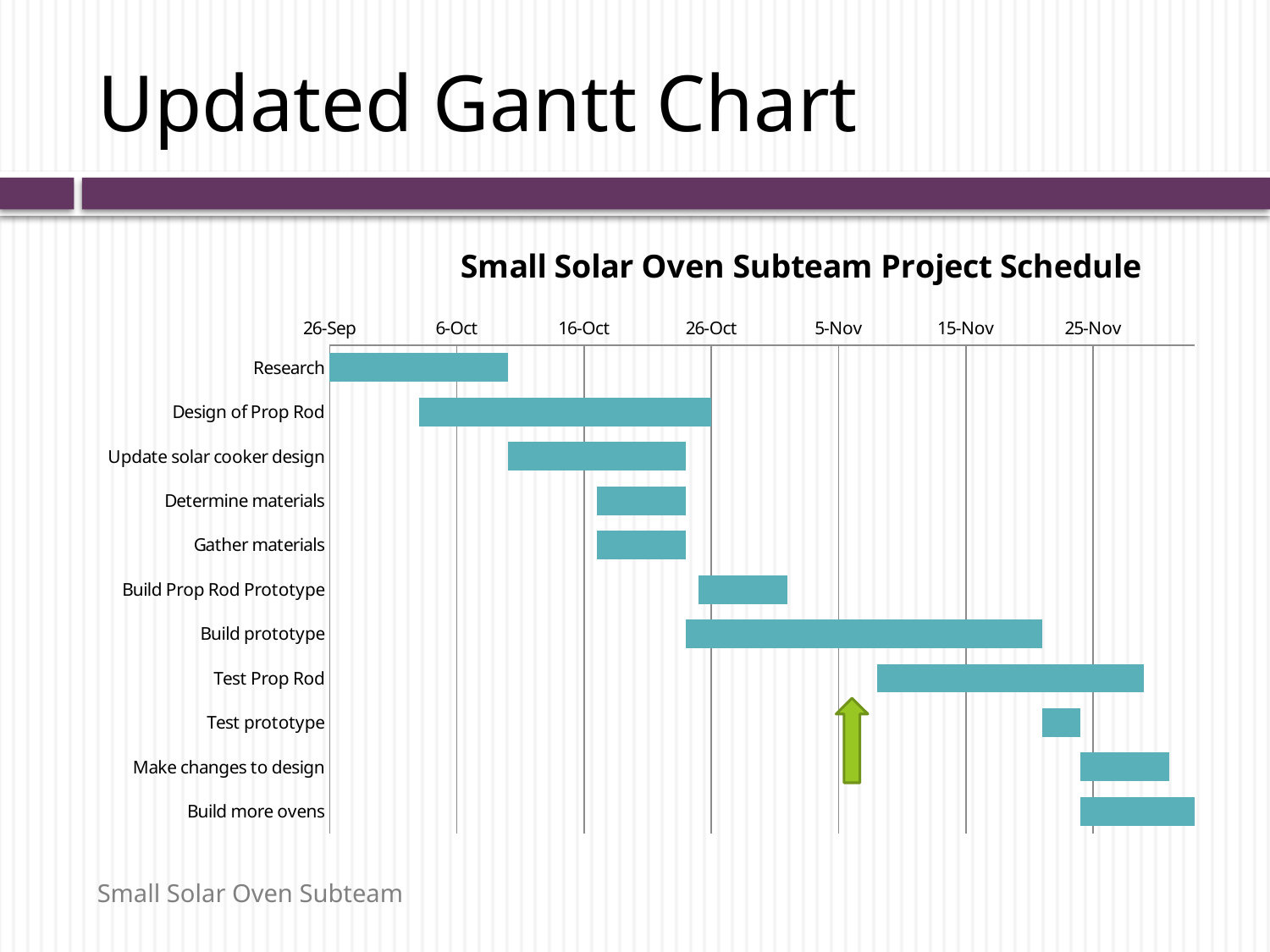
Which task has the longest bar in the chart? Build prototype What kind of chart is shown on the slide? Bar chart (Gantt chart) Which task starts earlier, Test Prop Rod or Test prototype? Test Prop Rod On which axis date does the Design of Prop Rod bar end? 26-Oct On which axis date does the Research bar begin? 26-Sep Does the Test Prop Rod bar end before or after 25-Nov? after What is the title of the chart? Small Solar Oven Subteam Project Schedule Which task ends later, Make changes to design or Build more ovens? Build more ovens How many tasks are listed on the vertical axis of the chart? 11 Does the Research bar end before or after 16-Oct? before Which task has the shortest bar in the chart? Test prototype Which task starts first in the schedule? Research